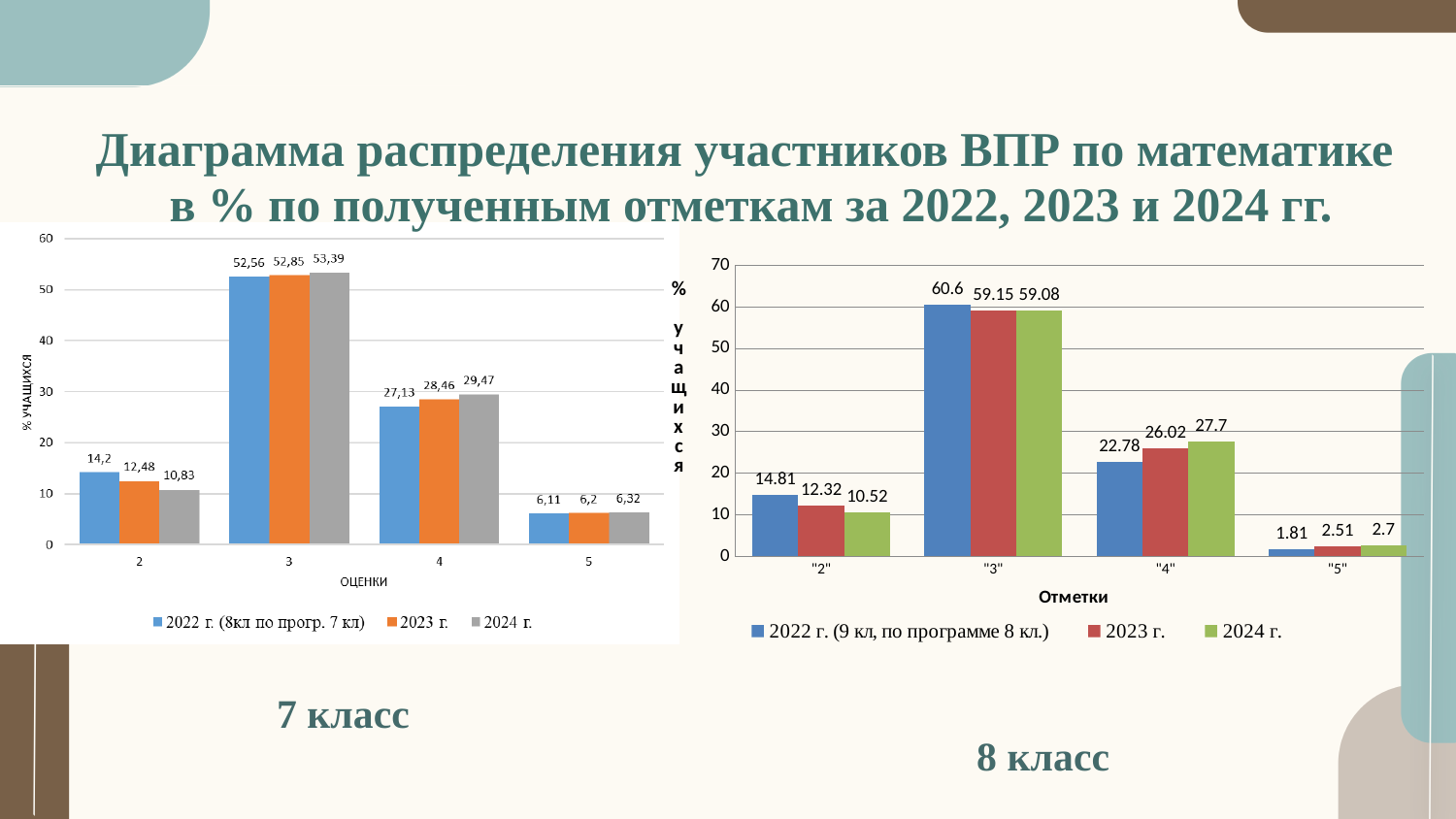
In the 7 класс chart on the left, which is larger for grade 4: the 2022 г. value or the 2024 г. value? 2024 г. In the 8 класс chart on the right, is the 2023 г. value for grade "3" greater or less than 50? greater In the 8 класс chart on the right, which grade has the lowest value for 2022 г.? "5" In the 7 класс chart on the left, which grade has the highest value for 2023 г.? 3 In the 8 класс chart on the right, what is the value for 2022 г. for grade "3"? 60.6 In the 8 класс chart on the right, what is the difference between the 2024 г. and 2022 г. values for grade "4"? 4.92 How many series does the legend of the 7 класс chart on the left list? 3 How many grade categories are shown on the x axis of the 8 класс chart on the right? 4 In the 8 класс chart on the right, what is the value for 2024 г. for grade "5"? 2.7 In the 7 класс chart on the left, what is the value for 2024 г. for grade 3? 53,39 In the 7 класс chart on the left, what is the difference between the 2022 г. and 2024 г. values for grade 2? 3,37 What kind of chart is the 8 класс chart on the right? Bar chart